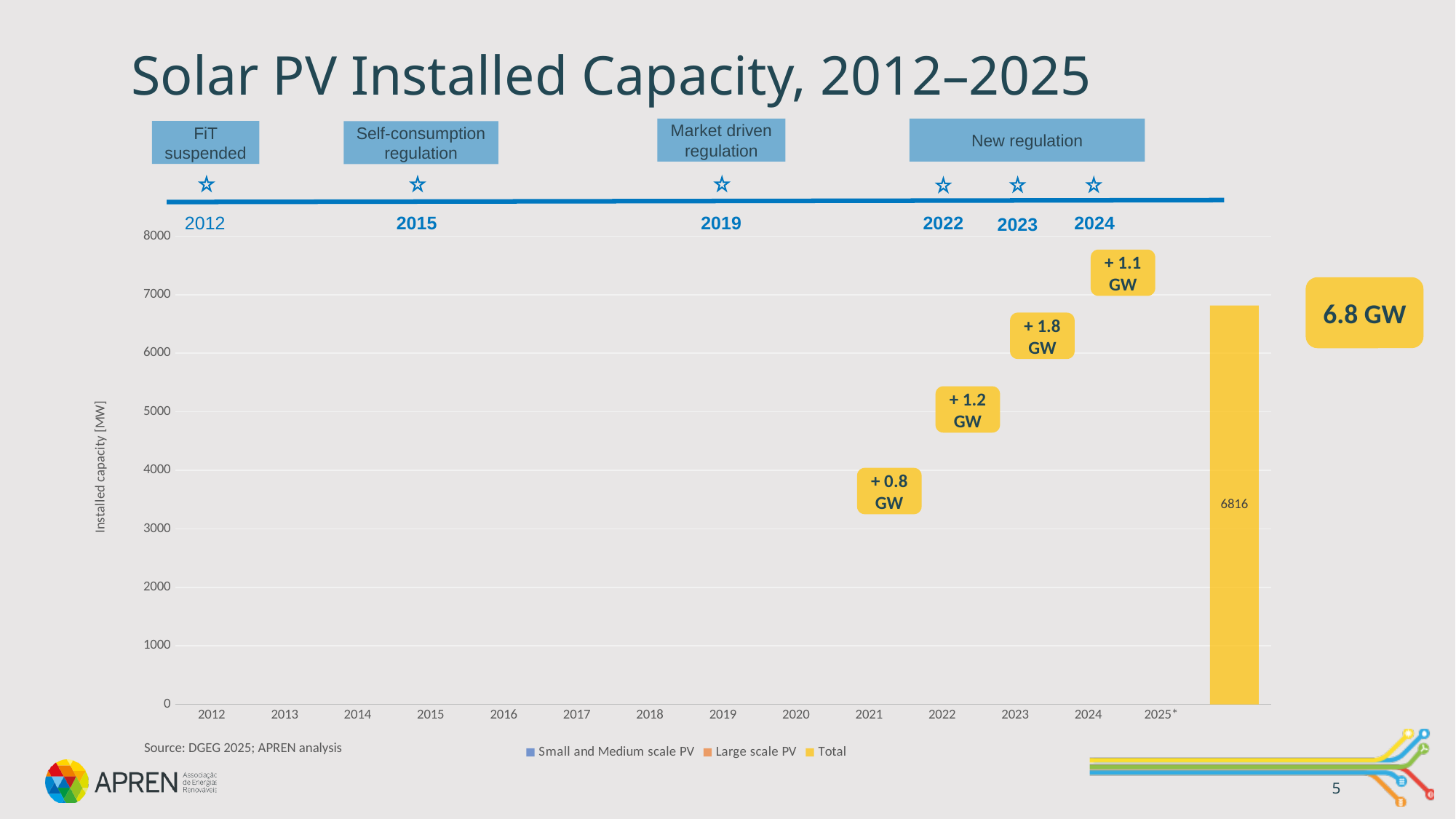
How many series does the legend list? 3 What is the value of the Total bar for 2025*? 6816 What are the three legend entries of the chart? Small and Medium scale PV, Large scale PV, Total What capacity addition is annotated above the chart for 2023? + 1.8 GW How many year categories are shown on the x axis? 14 Is the value of the 2025* bar greater or less than 7000? less Which year has the largest annotated capacity addition? 2023 What capacity addition is annotated above the chart for 2021? + 0.8 GW What is the label of the vertical axis? Installed capacity [MW] Which year has the smallest annotated capacity addition? 2021 What kind of chart is shown on the slide? bar chart Is the value of the 2025* bar greater or less than 6000? greater